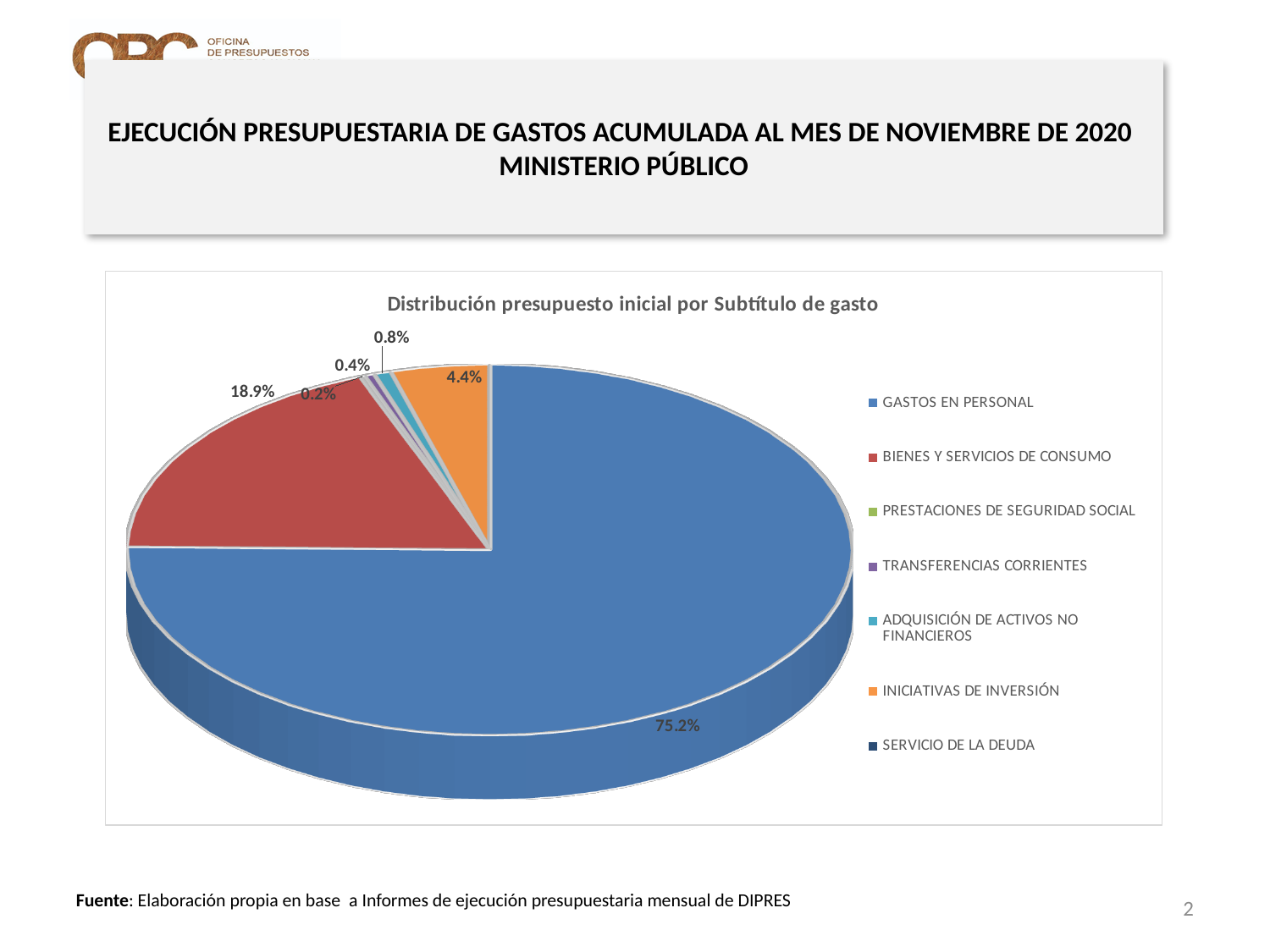
Which is larger, the slice for BIENES Y SERVICIOS DE CONSUMO or the slice for INICIATIVAS DE INVERSIÓN? BIENES Y SERVICIOS DE CONSUMO Is the share for GASTOS EN PERSONAL greater or less than 50%? greater What share of the pie does GASTOS EN PERSONAL represent? 75.2% What is the difference in percentage points between GASTOS EN PERSONAL and BIENES Y SERVICIOS DE CONSUMO? 56.3 percentage points What share of the pie does BIENES Y SERVICIOS DE CONSUMO represent? 18.9% What is the title of the chart? Distribución presupuesto inicial por Subtítulo de gasto What colour is the slice for GASTOS EN PERSONAL? Blue What is the combined share of GASTOS EN PERSONAL and BIENES Y SERVICIOS DE CONSUMO? 94.1% What share of the pie does INICIATIVAS DE INVERSIÓN represent? 4.4% Which category has the largest slice of the pie? GASTOS EN PERSONAL What type of chart is shown on the slide? Pie chart How many categories does the legend list? 7